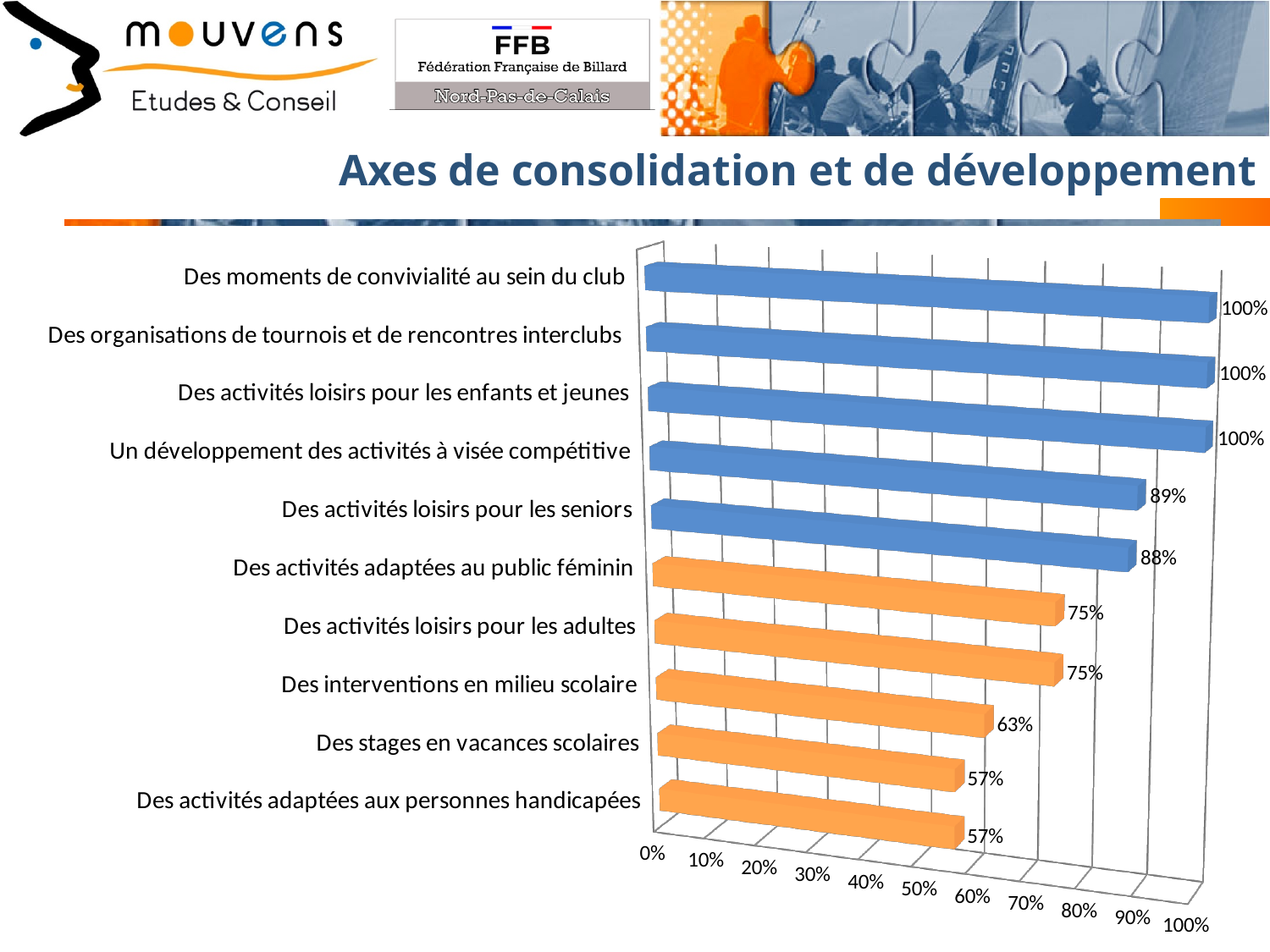
What is the value for "Un développement des activités à visée compétitive"? 89% What is the highest value shown in the chart? 100% Is the value for "Des interventions en milieu scolaire" greater or less than 50%? greater Which has the larger value: "Des activités loisirs pour les seniors" or "Des activités loisirs pour les adultes"? Des activités loisirs pour les seniors How many categories are shown in the chart? 10 What is the value for "Des stages en vacances scolaires"? 57% What is the value for "Des activités adaptées au public féminin"? 75% What is the difference between the values for "Un développement des activités à visée compétitive" and "Des stages en vacances scolaires"? 32 percentage points What is the lowest value shown in the chart? 57% What is the value for "Des interventions en milieu scolaire"? 63% What kind of chart is shown on the slide? Bar chart What is the value for "Des activités loisirs pour les seniors"? 88%